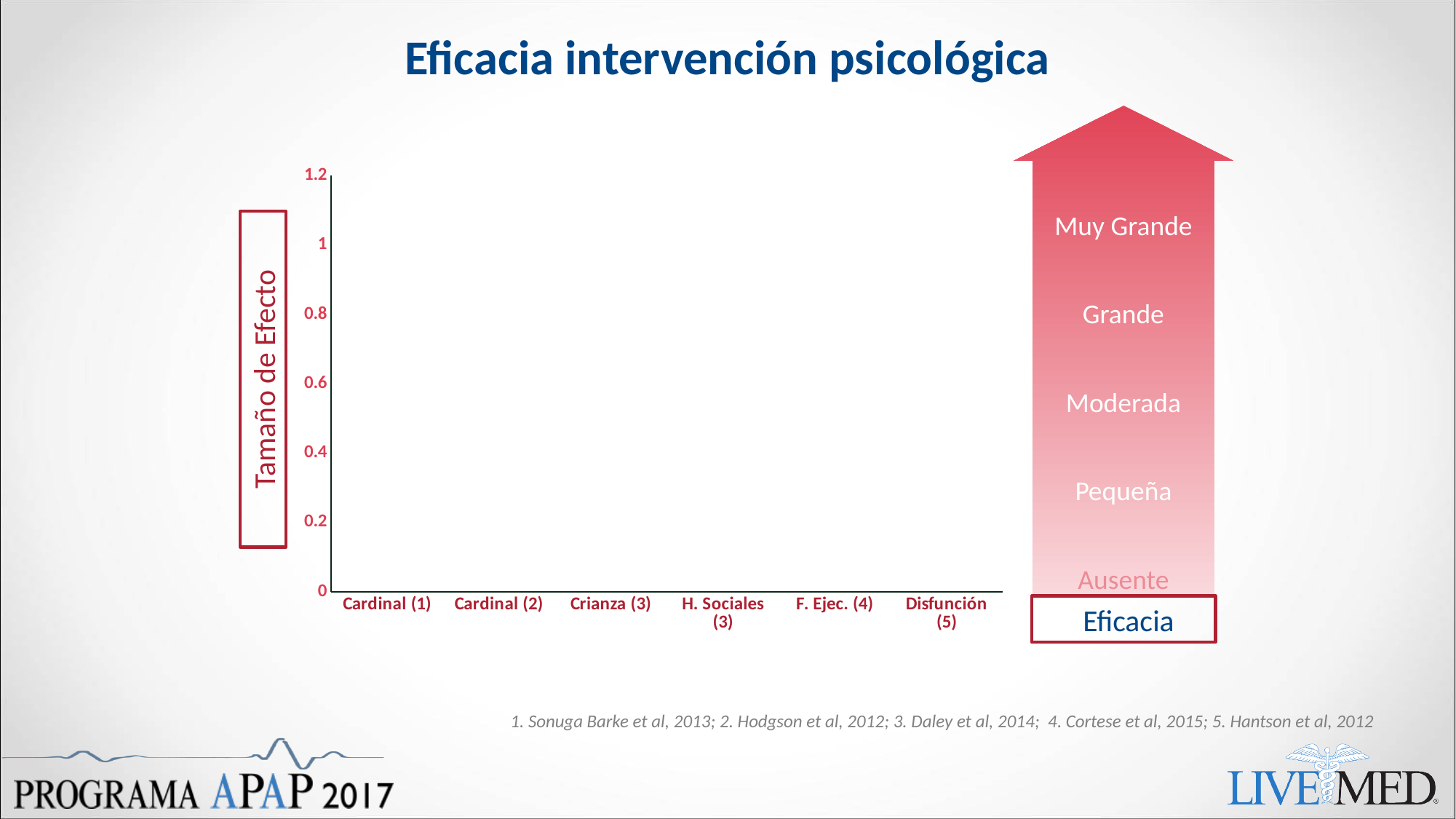
What is the first category on the x axis of the chart? Cardinal (1) How many categories are listed along the x axis of the chart? 6 What is the label of the y axis of the chart? Tamaño de Efecto What is the highest value shown on the y axis of the chart? 1.2 What is the last category on the x axis of the chart? Disfunción (5)